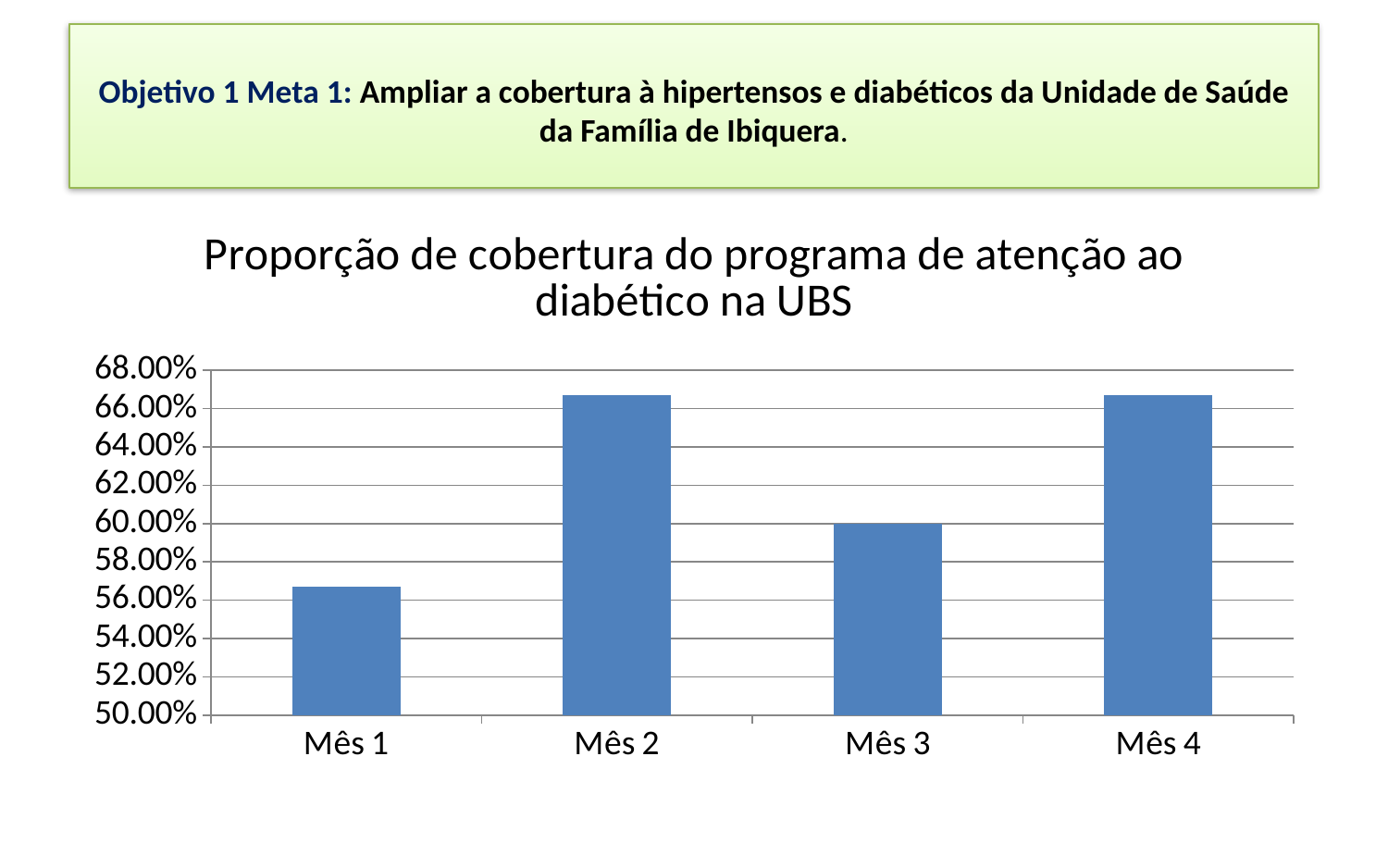
Is the value for Mês 2 greater or less than 64.00%? greater How many months (categories) are plotted on the chart? 4 Is the value for Mês 1 greater or less than 58.00%? less Which is larger, the value for Mês 2 or the value for Mês 3? Mês 2 Which month has the lowest value? Mês 1 Which is larger, the value for Mês 1 or the value for Mês 3? Mês 3 Does the value rise or fall from Mês 1 to Mês 2? rise What is the lowest value shown on the vertical axis? 50.00% What is the value for Mês 3? 60.00% What is the title of the chart? Proporção de cobertura do programa de atenção ao diabético na UBS Is the value for Mês 4 greater or less than 64.00%? greater What kind of chart is shown on the slide? bar chart